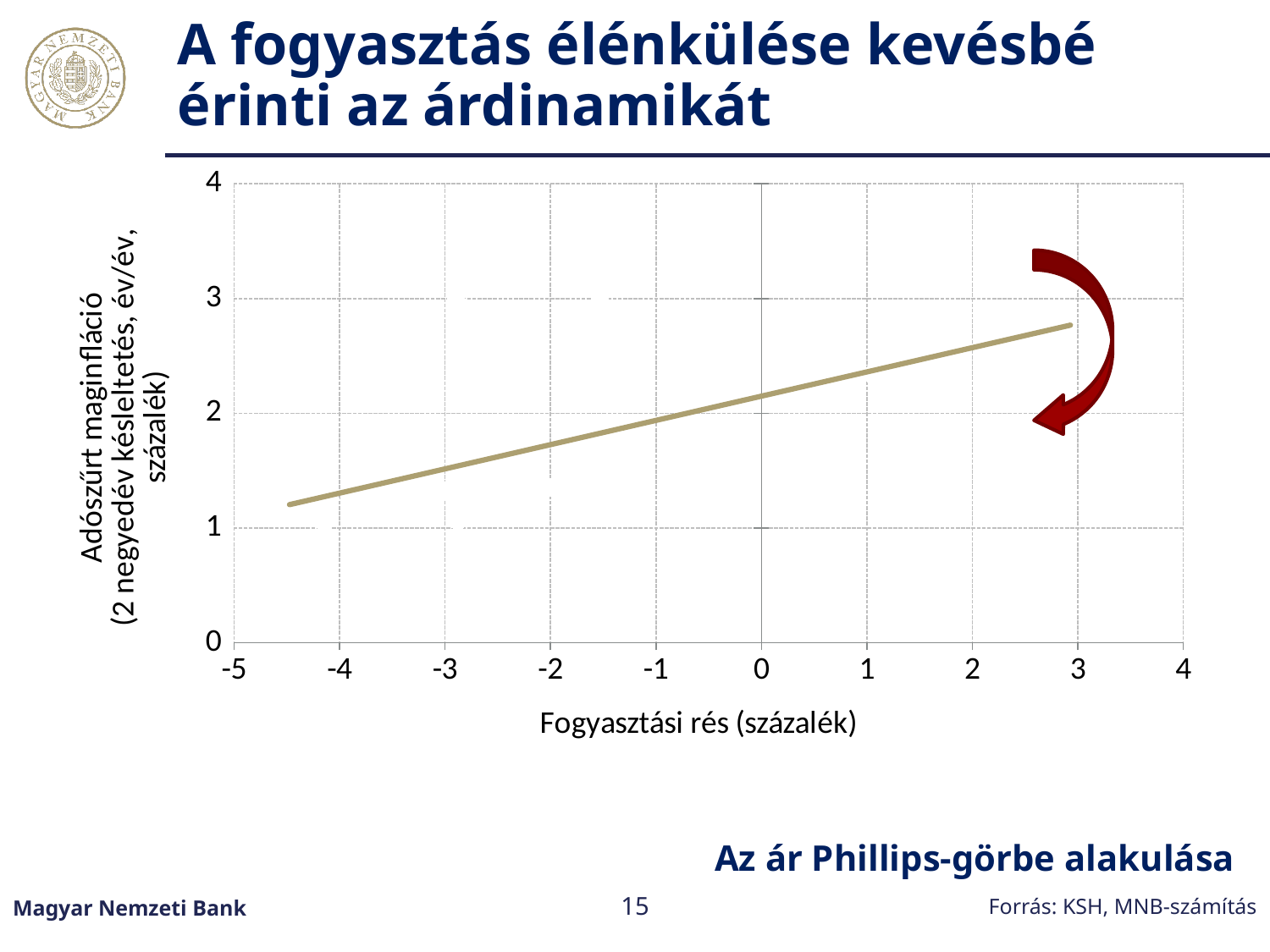
Is the lowest point of the line greater or less than 1? greater Is the value of the line at a consumption gap of -4 greater or less than 2? less Is the highest point of the line greater or less than 3? less Does the line rise or fall as the consumption gap (Fogyasztási rés) increases along the x axis? rises What is the title of the chart? Az ár Phillips-görbe alakulása What is the label of the x axis? Fogyasztási rés (százalék) What kind of chart is shown on the slide? line chart